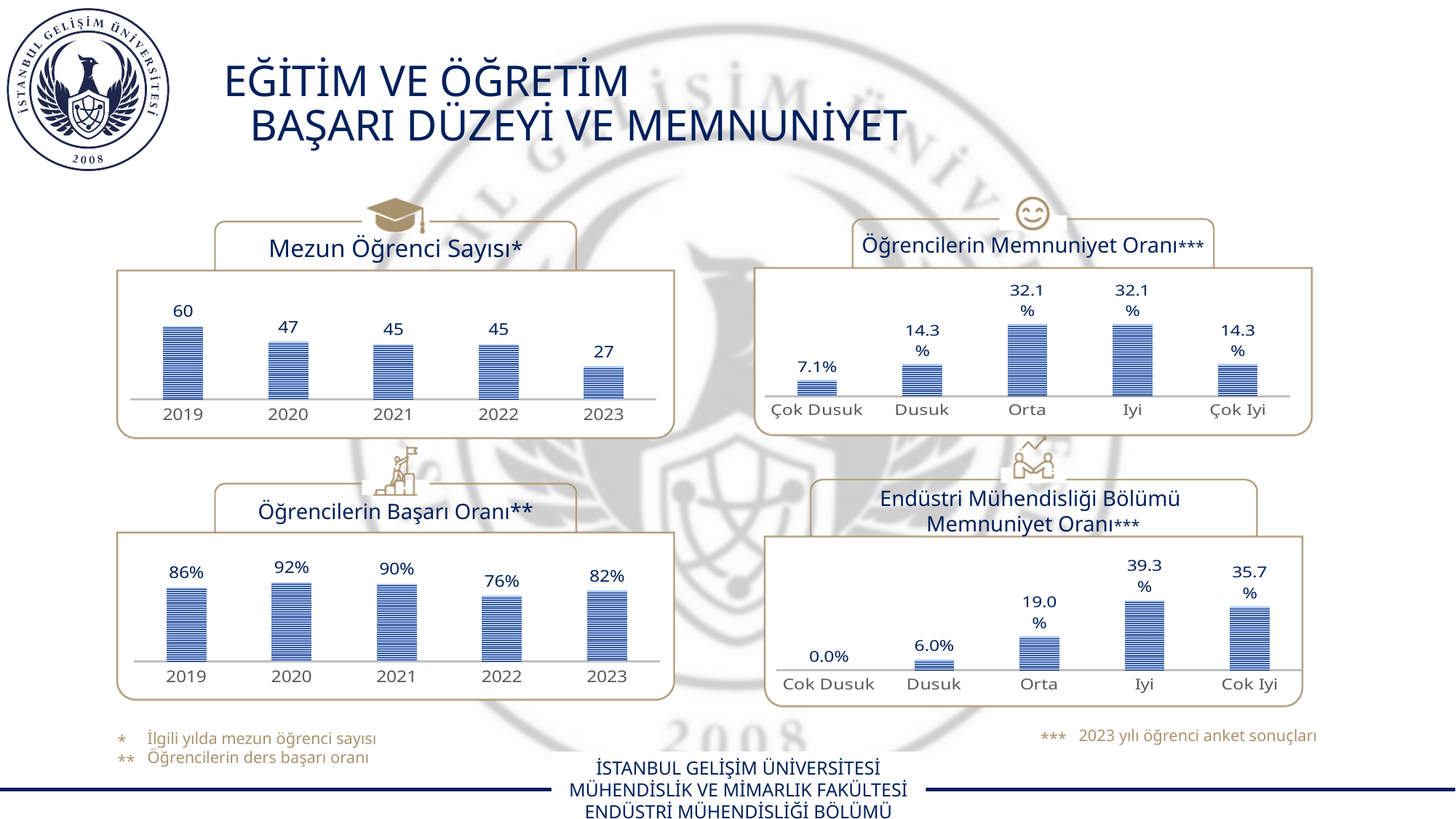
In the "Mezun Öğrenci Sayısı" chart, how many years are shown? 5 In the "Endüstri Mühendisliği Bölümü Memnuniyet Oranı" chart, what is the value for Iyi? 39.3% In the "Mezun Öğrenci Sayısı" chart, what is the value for 2019? 60 In the "Mezun Öğrenci Sayısı" chart, which year has the lowest value? 2023 In the "Öğrencilerin Başarı Oranı" chart, what is the difference between the values for 2020 and 2022? 16% In the "Öğrencilerin Memnuniyet Oranı" chart, what is the value for Çok Dusuk? 7.1% In the "Öğrencilerin Başarı Oranı" chart, what is the value for 2022? 76% What kind of chart is the "Öğrencilerin Başarı Oranı" chart? Bar chart In the "Mezun Öğrenci Sayısı" chart, what is the difference between the values for 2019 and 2023? 33 In the "Öğrencilerin Memnuniyet Oranı" chart, which is larger, Dusuk or Orta? Orta In the "Öğrencilerin Başarı Oranı" chart, which year has the highest value? 2020 In the "Endüstri Mühendisliği Bölümü Memnuniyet Oranı" chart, which category has the lowest value? Cok Dusuk